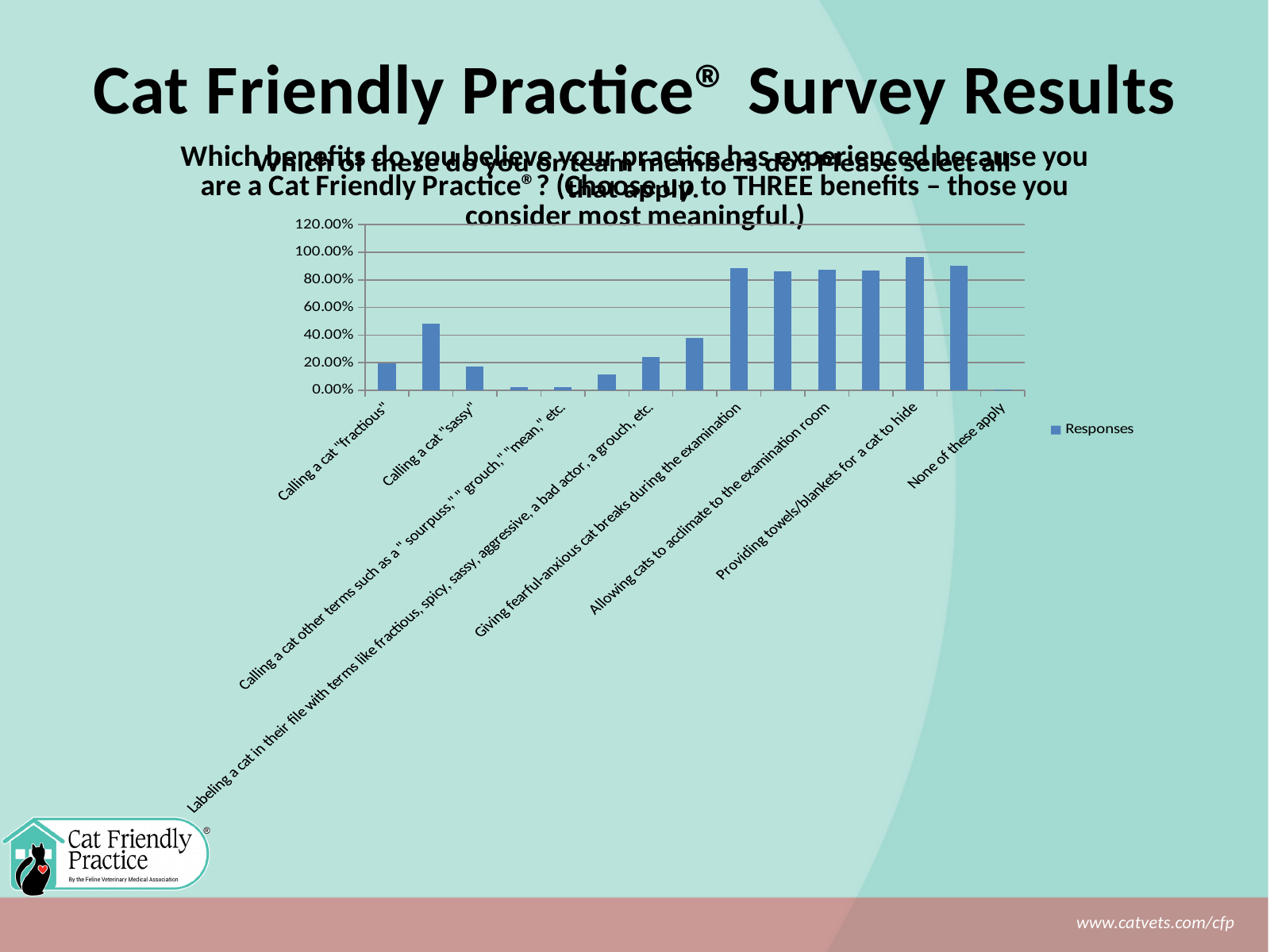
Which labeled category has the highest value in the chart? Providing towels/blankets for a cat to hide Which has the larger value: 'Providing towels/blankets for a cat to hide' or 'Calling a cat "fractious"'? Providing towels/blankets for a cat to hide What is the name of the series shown in the chart's legend? Responses Is the value for 'Allowing cats to acclimate to the examination room' greater or less than 80.00%? greater What kind of chart is shown on the slide? bar chart What is the highest value shown on the chart's vertical axis? 120.00% How many series does the chart's legend list? 1 Is the value for 'Providing towels/blankets for a cat to hide' greater or less than 80.00%? greater Is the value for 'Calling a cat "fractious"' greater or less than 40.00%? less